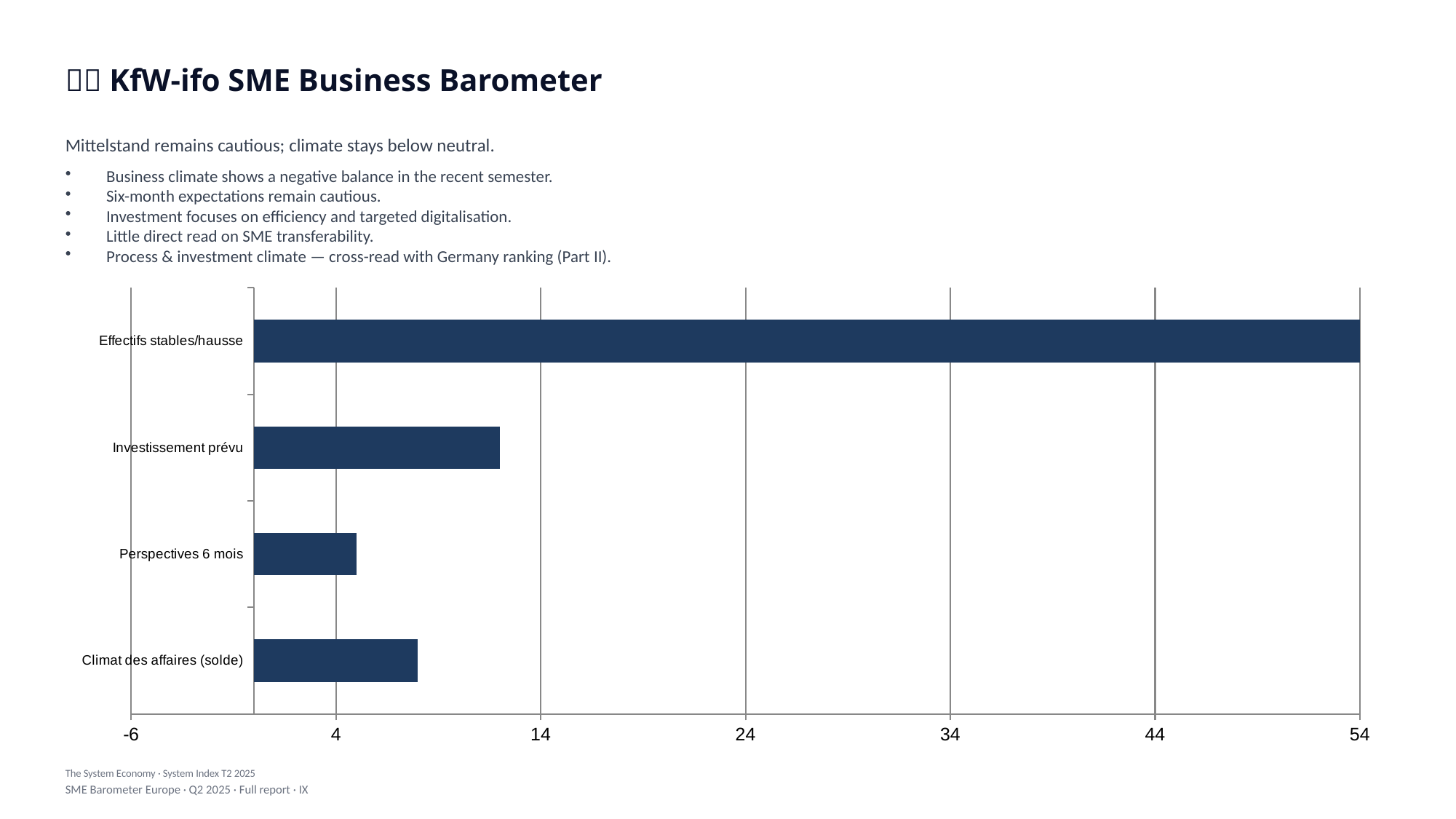
Which is larger, the value for Climat des affaires (solde) or the value for Perspectives 6 mois? Climat des affaires (solde) How many categories are plotted in the chart? 4 What is the value for Effectifs stables/hausse? 54 Which category has the lowest value in the chart? Perspectives 6 mois Which is larger, the value for Investissement prévu or the value for Climat des affaires (solde)? Investissement prévu Is the value for Climat des affaires (solde) greater or less than 14? less Is the value for Investissement prévu greater or less than 4? greater Is the value for Investissement prévu greater or less than 14? less What kind of chart is shown on the slide? Bar chart Which category has the highest value in the chart? Effectifs stables/hausse What is the lowest value shown on the horizontal axis of the chart? -6